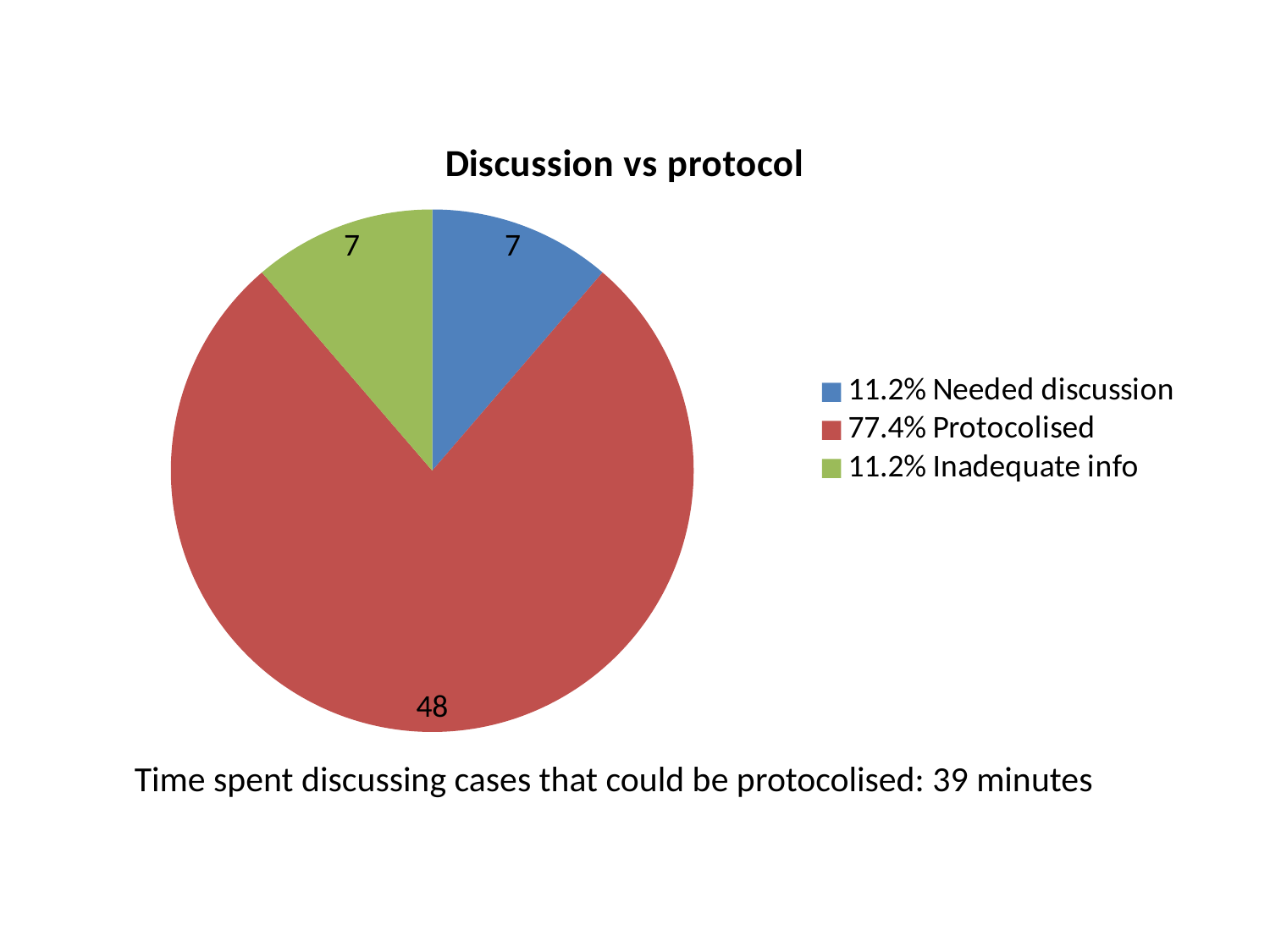
What percentage share of the pie does the Protocolised slice represent, according to the legend? 77.4% How many slices does the pie chart have? 3 What colour is the Inadequate info slice? green What is the value for the Needed discussion slice? 7 What type of chart is shown on the slide? pie chart What percentage share of the pie does the Needed discussion slice represent, according to the legend? 11.2% What is the difference between the Protocolised value and the Needed discussion value? 41 Which category has the largest slice of the pie? Protocolised What is the title of the chart? Discussion vs protocol What is the value for the Inadequate info slice? 7 Which is larger, the Protocolised slice or the Inadequate info slice? Protocolised What is the value for the Protocolised slice? 48